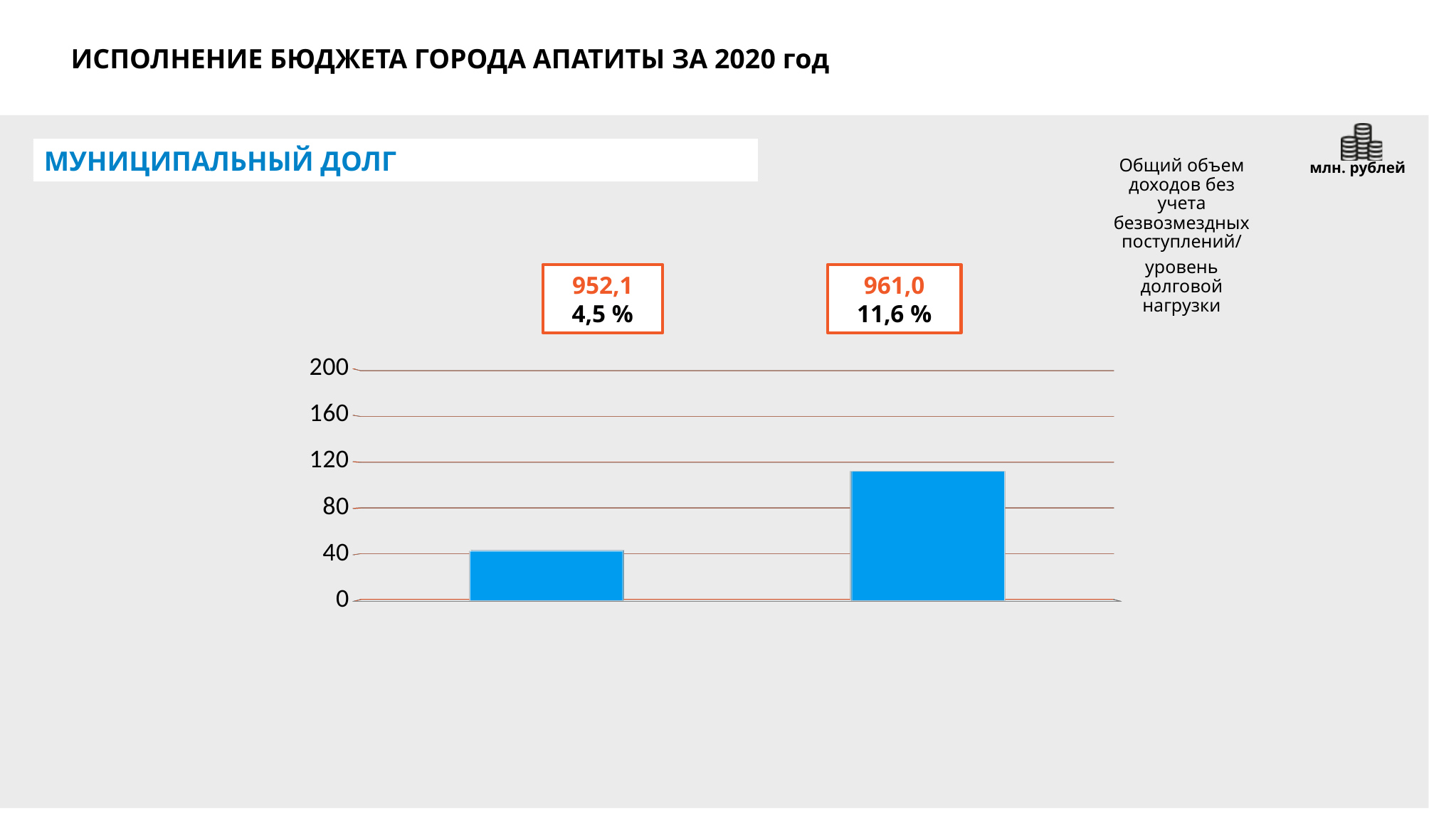
Is the value of the left bar greater or less than 80? less Which bar has the highest value? the right bar What is the title of the chart? МУНИЦИПАЛЬНЫЙ ДОЛГ What kind of chart is shown on the slide? bar chart What debt load level (уровень долговой нагрузки) is shown in the box above the right bar? 11,6 % How many bars are plotted in the chart? 2 Which bar is taller, the left bar or the right bar? the right bar Is the value of the right bar greater or less than 80? greater Is the value of the right bar greater or less than 120? less Which bar has the lowest value? the left bar Do the bar values rise or fall from left to right? rise